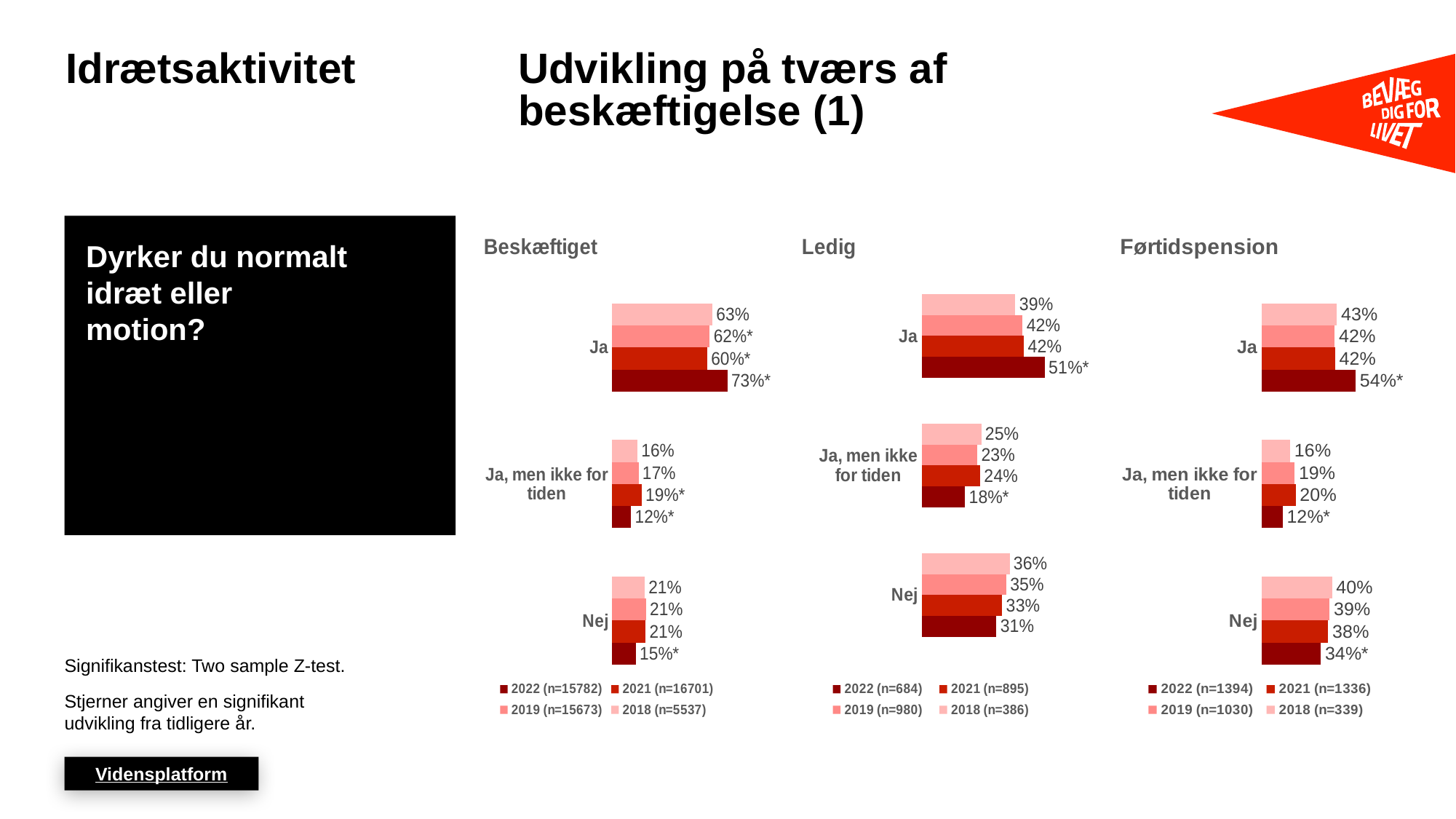
In the Ledig chart, which is larger: the 2022 value for Ja or the 2022 value for Nej? Ja In the Ledig chart, what is the value for 2018 in the Nej category? 36% What kind of chart is the Beskæftiget chart? Bar chart In the Ledig chart, what is the value for 2021 in the Ja, men ikke for tiden category? 24% In the Førtidspension chart, which year has the lowest value in the Nej category? 2022 In the Beskæftiget chart, what is the difference between the 2022 and 2018 values in the Ja category? 10 percentage points In the Beskæftiget chart, which year has the highest value in the Ja category? 2022 How many categories are shown in the Førtidspension chart? 3 In the Beskæftiget chart, what is the value for 2022 in the Ja category? 73%* In the Førtidspension chart, what is the value for 2022 in the Ja category? 54%* How many series does the legend list in the Ledig chart? 4 In the Ledig chart, what sample size is given for 2022 in the legend? n=684